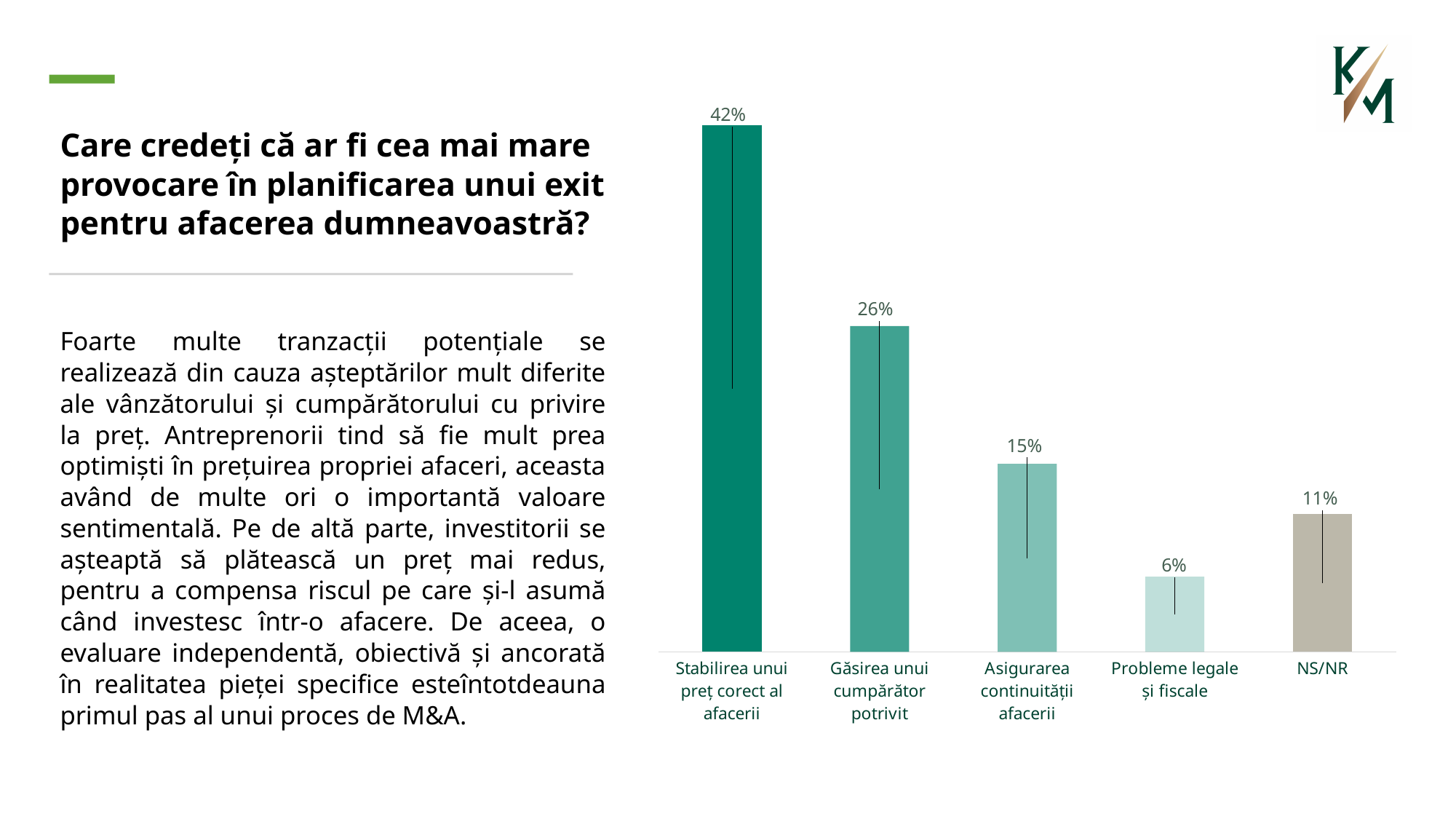
Which category has the highest value? Stabilirea unui preț corect al afacerii Which is larger, the value for 'NS/NR' or the value for 'Probleme legale și fiscale'? NS/NR What is the difference between the values for 'Stabilirea unui preț corect al afacerii' and 'Găsirea unui cumpărător potrivit'? 16% How many categories are shown in the chart? 5 Which category has the lowest value? Probleme legale și fiscale What kind of chart is shown on the slide? Bar chart What is the difference between the values for 'Asigurarea continuității afacerii' and 'NS/NR'? 4% What is the value for 'Asigurarea continuității afacerii'? 15% What is the value for 'Probleme legale și fiscale'? 6% What is the value for 'Găsirea unui cumpărător potrivit'? 26% What is the value for 'NS/NR'? 11% What is the value for 'Stabilirea unui preț corect al afacerii'? 42%